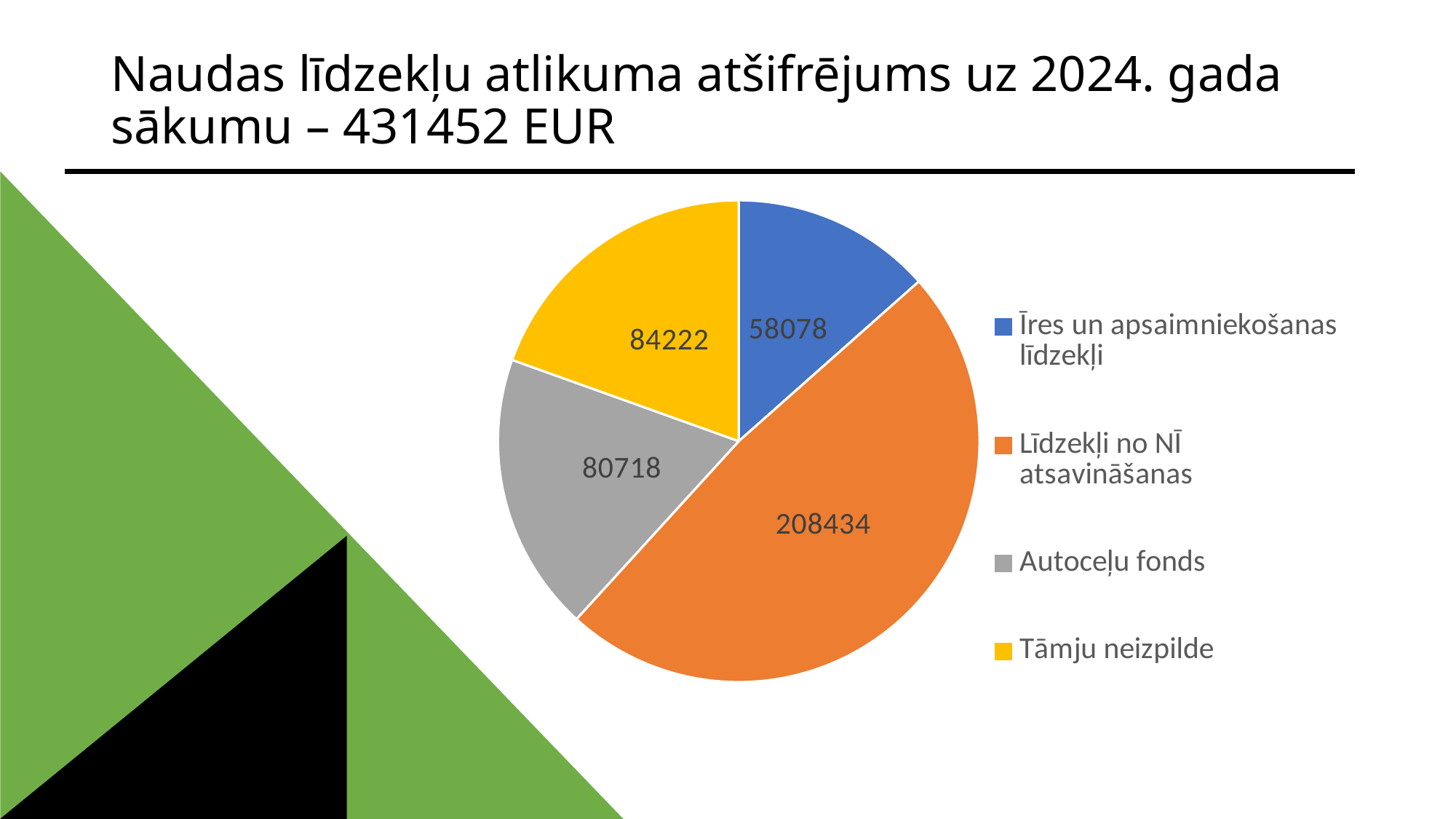
What is the difference between the Tāmju neizpilde value and the Autoceļu fonds value? 3504 Which is larger, the Tāmju neizpilde value or the Autoceļu fonds value? Tāmju neizpilde How many slices does the pie chart have? 4 What colour is the Autoceļu fonds slice? Gray Which category has the largest slice of the pie? Līdzekļi no NĪ atsavināšanas Which category has the smallest slice of the pie? Īres un apsaimniekošanas līdzekļi What value is shown for the Autoceļu fonds slice? 80718 What value is shown for the Īres un apsaimniekošanas līdzekļi slice? 58078 What value is shown for the Līdzekļi no NĪ atsavināšanas slice? 208434 What kind of chart is shown on the slide? Pie chart What value is shown for the Tāmju neizpilde slice? 84222 What is the difference between the Līdzekļi no NĪ atsavināšanas value and the Īres un apsaimniekošanas līdzekļi value? 150356